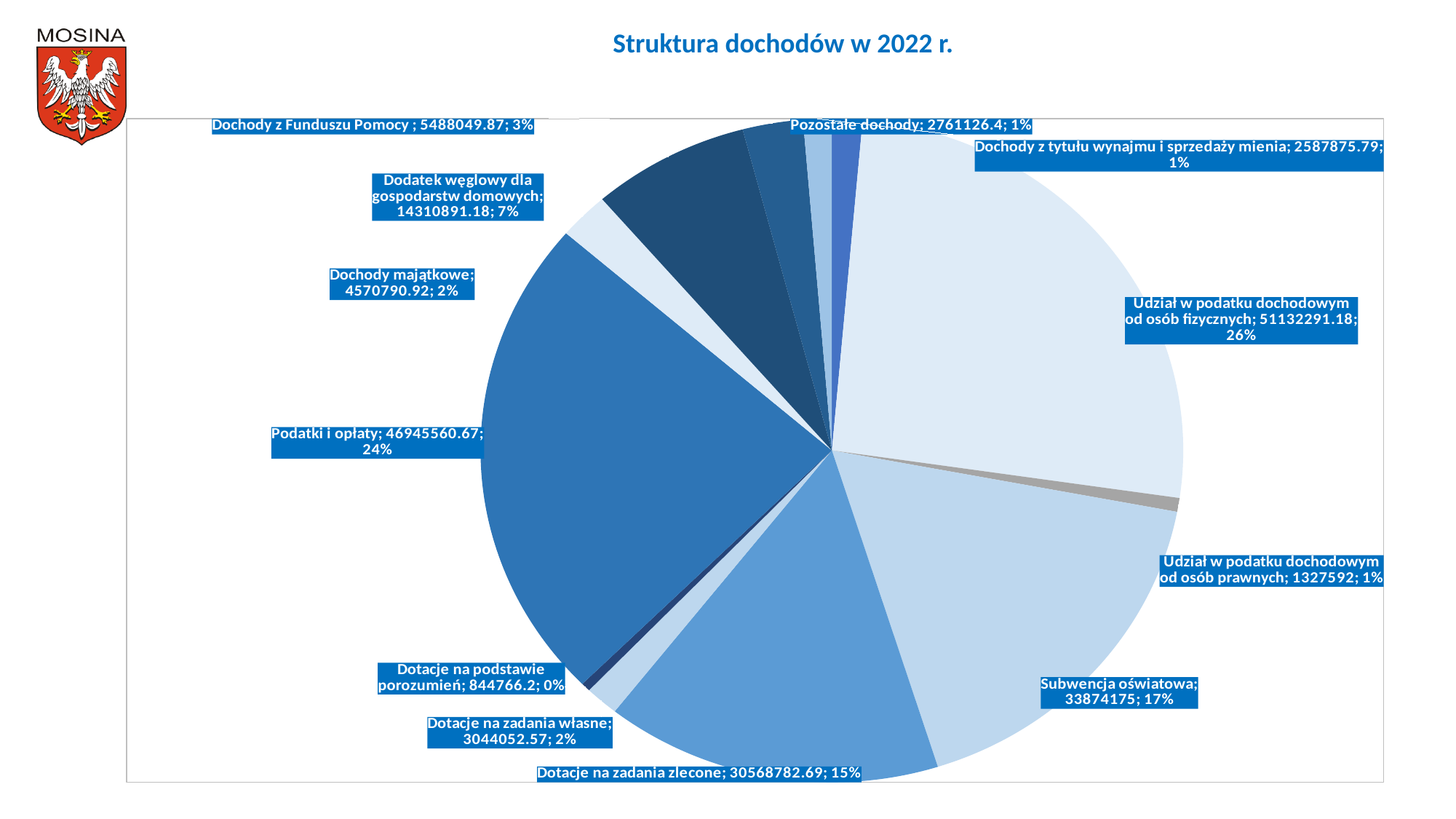
Which category has the smallest slice? Dotacje na podstawie porozumień What is the value for Dodatek węglowy dla gospodarstw domowych? 14310891.18 What is the difference between the values for Udział w podatku dochodowym od osób fizycznych and Podatki i opłaty? 4186730.51 What is the value for Podatki i opłaty? 46945560.67 What share of the pie does Dotacje na zadania zlecone represent? 15% Which is larger, Subwencja oświatowa or Dotacje na zadania zlecone? Subwencja oświatowa What is the title of the chart? Struktura dochodów w 2022 r. What kind of chart is shown on the slide? pie chart How many slices does the pie chart have? 12 Which category has the largest slice? Udział w podatku dochodowym od osób fizycznych What is the value for Subwencja oświatowa? 33874175 What share of the pie does Udział w podatku dochodowym od osób fizycznych represent? 26%